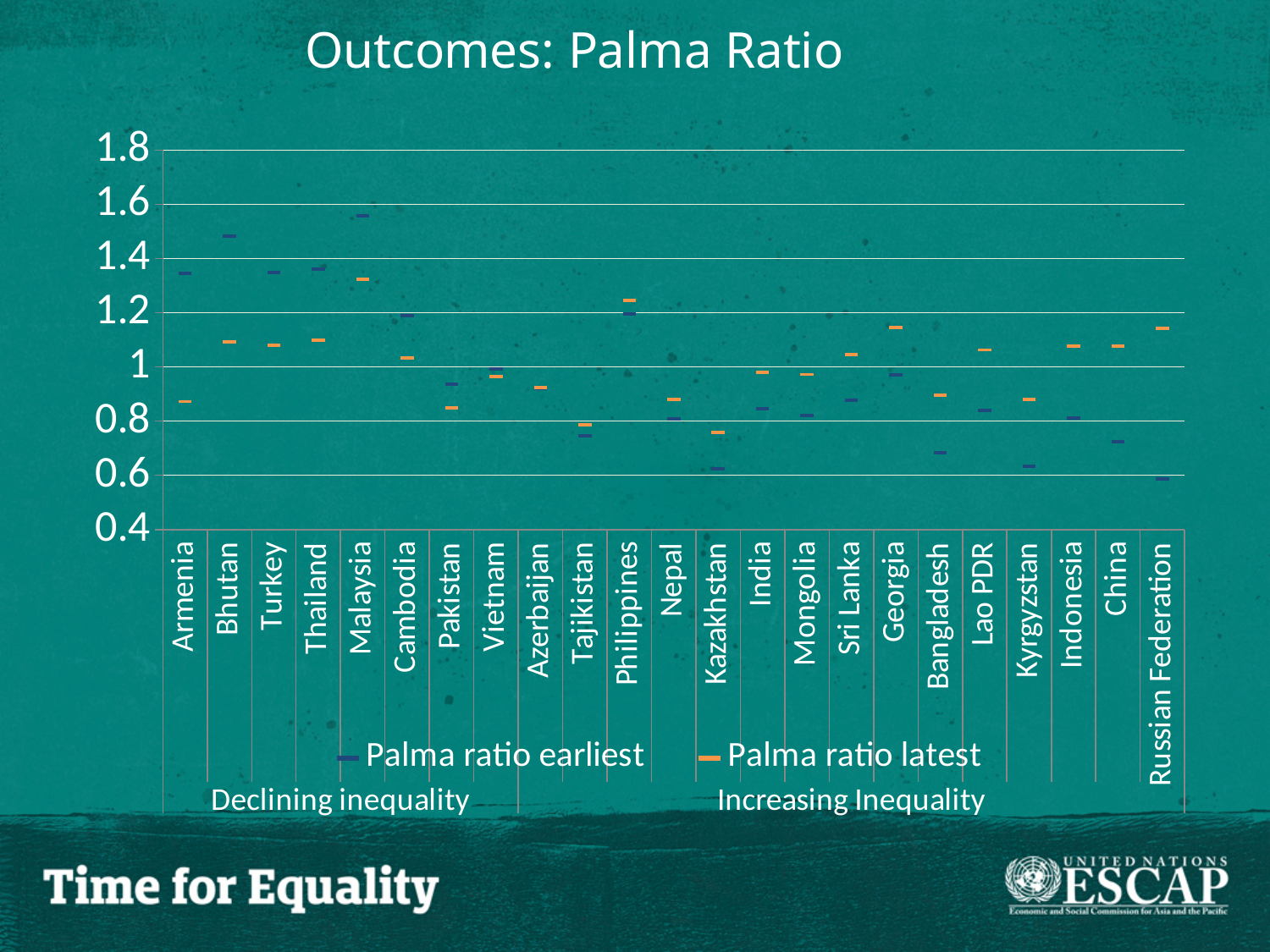
For Armenia, which is larger: the Palma ratio earliest or the Palma ratio latest? Palma ratio earliest Is the Palma ratio earliest value for Kazakhstan greater or less than 0.8? less Is the Palma ratio latest value for Armenia greater or less than 1? less How many countries are shown on the x axis? 23 How many series does the legend list? 2 What are the two series named in the legend? Palma ratio earliest and Palma ratio latest For Russian Federation, which is larger: the Palma ratio earliest or the Palma ratio latest? Palma ratio latest Is the Palma ratio earliest value for Malaysia greater or less than 1.4? greater Which country has the highest Palma ratio earliest value? Malaysia Which country has the highest Palma ratio latest value? Malaysia What is the title of the chart? Outcomes: Palma Ratio